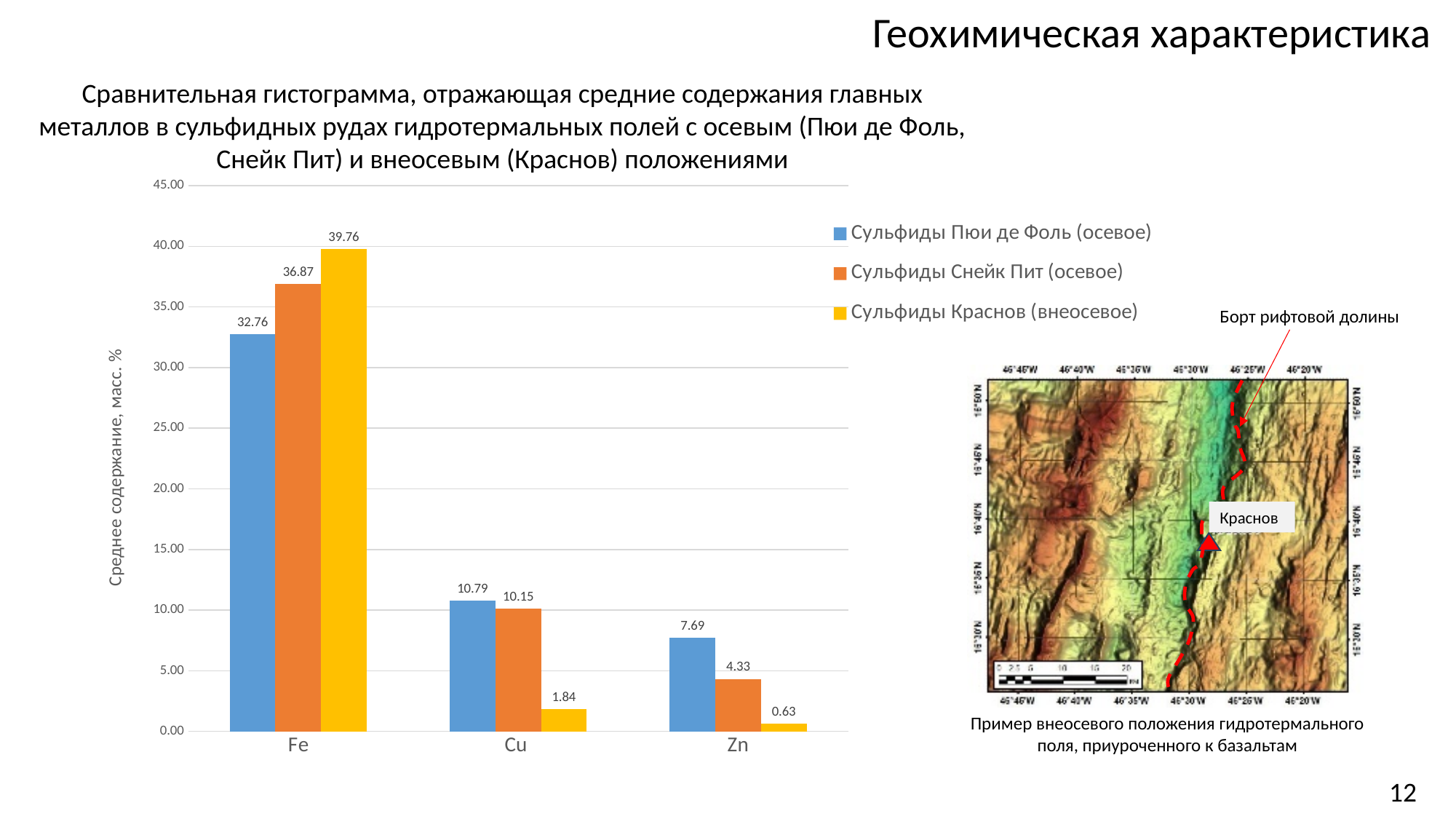
How many series does the legend list? 3 Which is larger for Cu: the Сульфиды Пюи де Фоль (осевое) value or the Сульфиды Снейк Пит (осевое) value? Сульфиды Пюи де Фоль (осевое) Which series has the highest value for Fe? Сульфиды Краснов (внеосевое) What is the value for Zn in the Сульфиды Снейк Пит (осевое) series? 4.33 Is the value for Zn in the Сульфиды Пюи де Фоль (осевое) series greater or less than 5.00? greater What kind of chart is shown on the slide? bar chart What is the label of the y axis? Среднее содержание, масс. % What is the difference between the Fe values for Сульфиды Краснов (внеосевое) and Сульфиды Пюи де Фоль (осевое)? 7.00 How many categories are shown on the x axis? 3 Which series has the lowest value for Zn? Сульфиды Краснов (внеосевое) What is the value for Cu in the Сульфиды Пюи де Фоль (осевое) series? 10.79 What is the value for Fe in the Сульфиды Краснов (внеосевое) series? 39.76